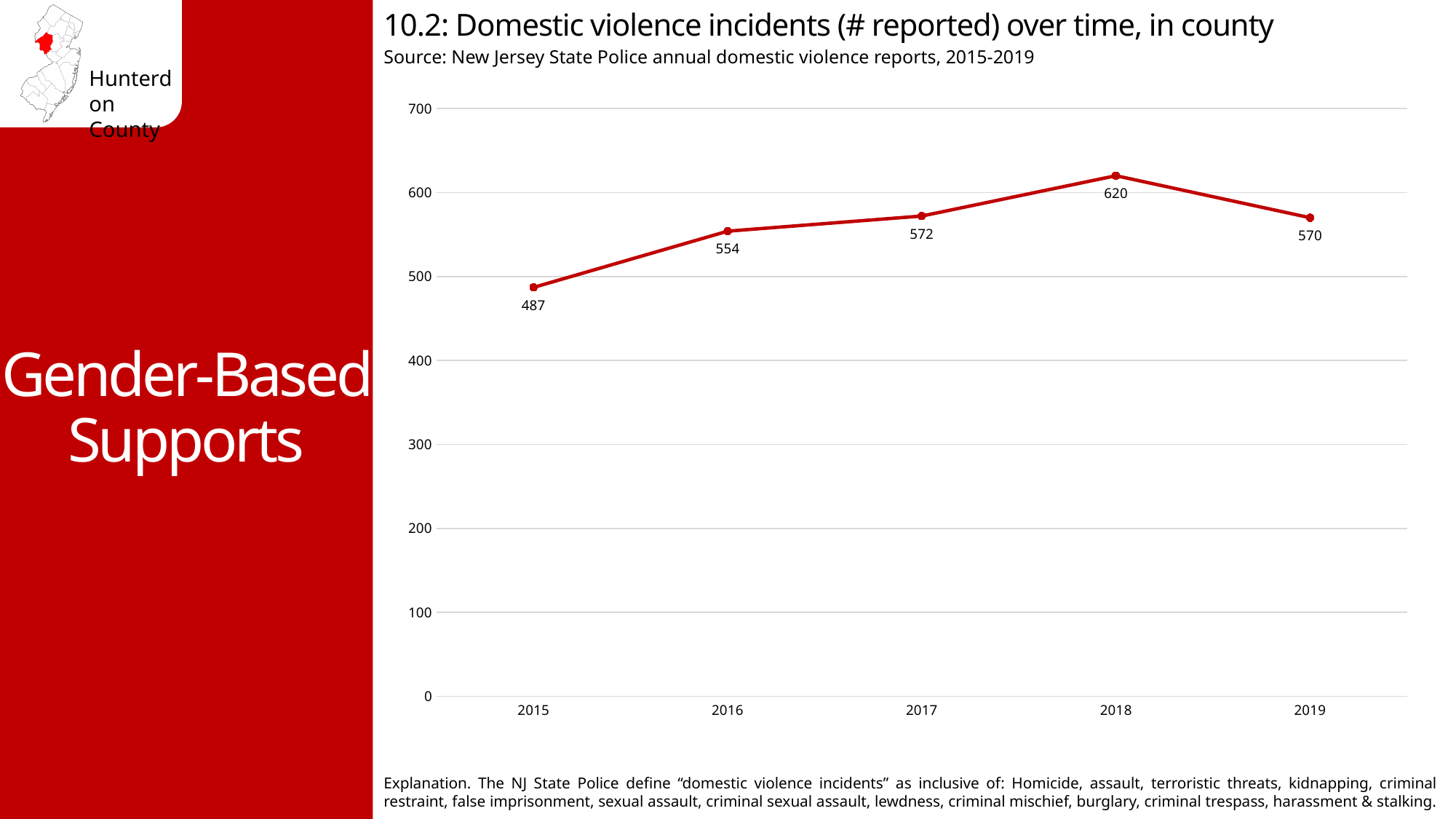
What was the number of reported domestic violence incidents in 2019? 570 What was the number of reported domestic violence incidents in 2018? 620 How many years are plotted on the chart? 5 What was the number of reported domestic violence incidents in 2015? 487 Is the value for 2015 greater or less than 500? less Did the number of reported incidents rise or fall from 2015 to 2018? rise What is the difference between the number of incidents in 2018 and 2015? 133 Which year had more reported incidents, 2016 or 2019? 2019 What kind of chart is shown on the slide? line chart What is the difference between the number of incidents in 2017 and 2016? 18 Which year had the highest number of reported domestic violence incidents? 2018 Which year had the lowest number of reported domestic violence incidents? 2015